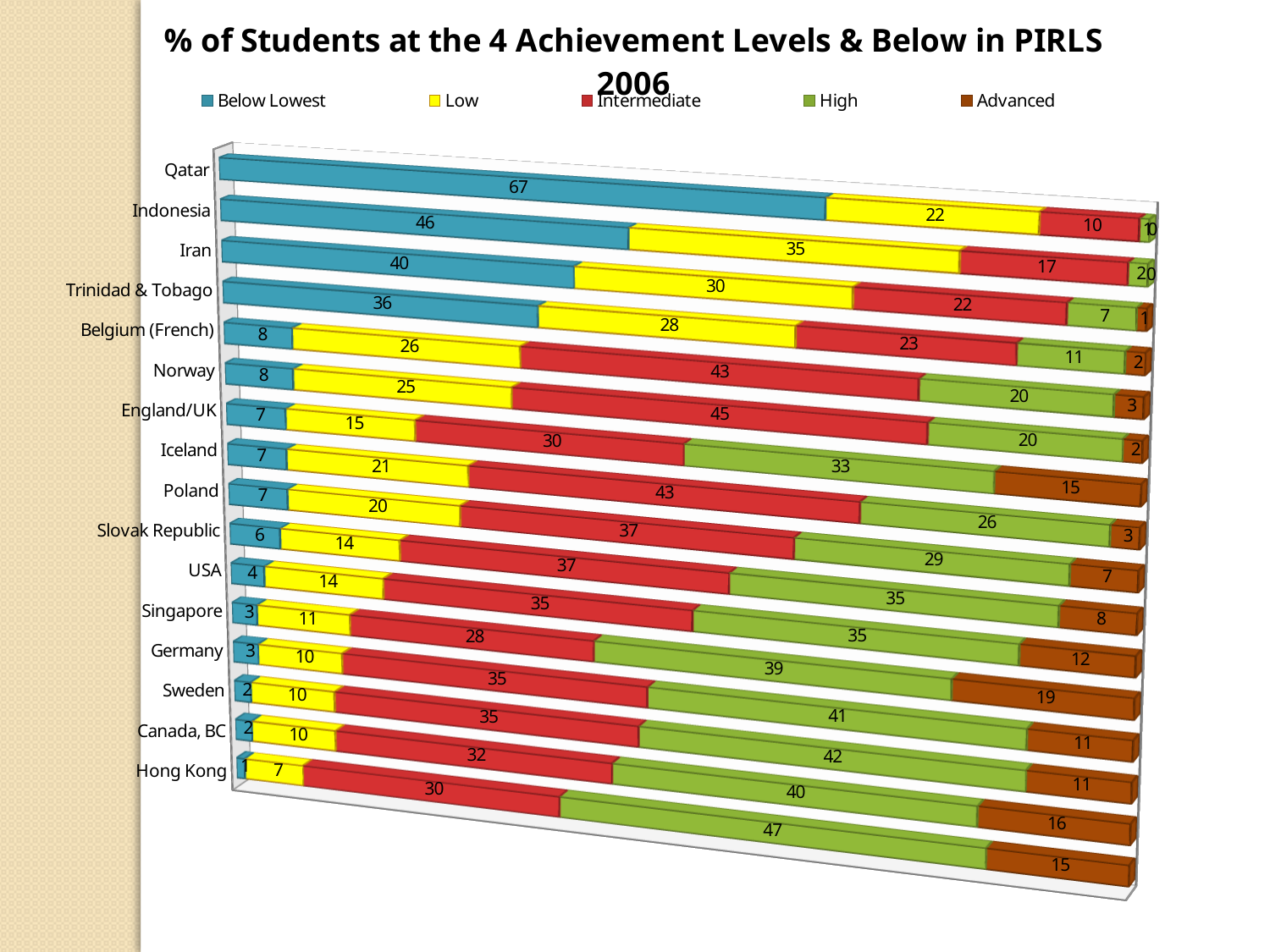
Which has a larger Intermediate percentage, Norway or Belgium (French)? Norway What percentage of students in Singapore are at the Advanced level? 19 What percentage of students in Hong Kong are at the High level? 47 What percentage of students in Norway are at the Intermediate level? 45 How many series does the legend list? 5 Which country has the lowest percentage of students at the Below Lowest level? Hong Kong What is the difference between the Below Lowest percentages for Qatar and Indonesia? 21 What is the total of the stacked bar for Hong Kong? 100 What type of chart is shown on the slide? Stacked bar chart What percentage of students in Qatar are at the Below Lowest level? 67 How many countries/regions are shown on the chart? 16 Which country has the highest percentage of students at the Below Lowest level? Qatar